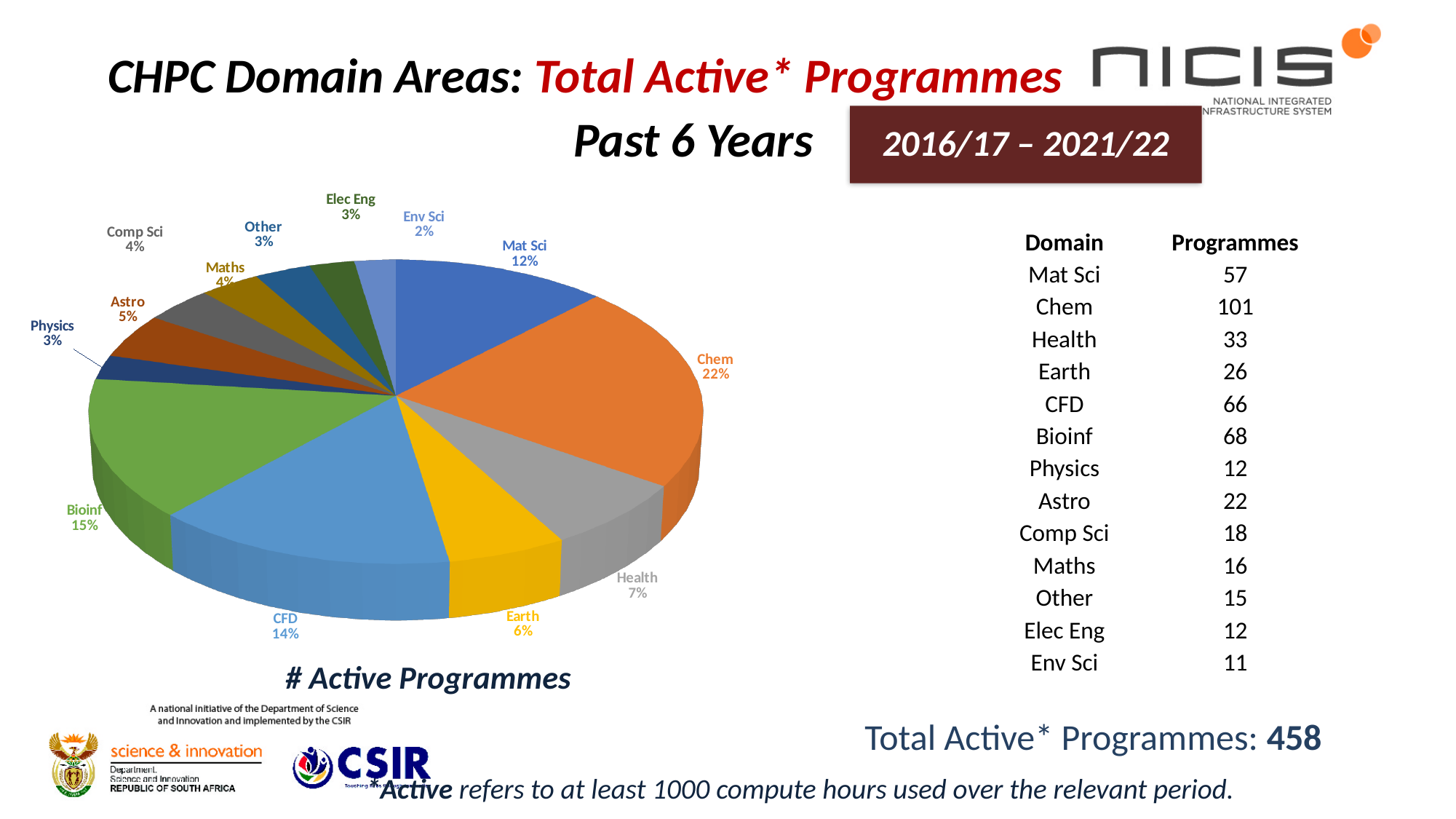
What type of chart is shown on the slide? pie chart What share of the pie does Chem account for? 22% Which slice is larger in the pie chart, Astro or Earth? Earth Which domain has the smallest slice of the pie chart? Env Sci What percentage is shown for CFD in the pie chart? 14% What percentage is shown for Bioinf in the pie chart? 15% Which domain has the largest slice of the pie chart? Chem How many slices does the pie chart have? 13 What percentage is shown for Health in the pie chart? 7% Which slice is larger in the pie chart, Bioinf or CFD? Bioinf What is the difference in percentage points between Chem and Mat Sci in the pie chart? 10 What is the title shown below the pie chart? # Active Programmes